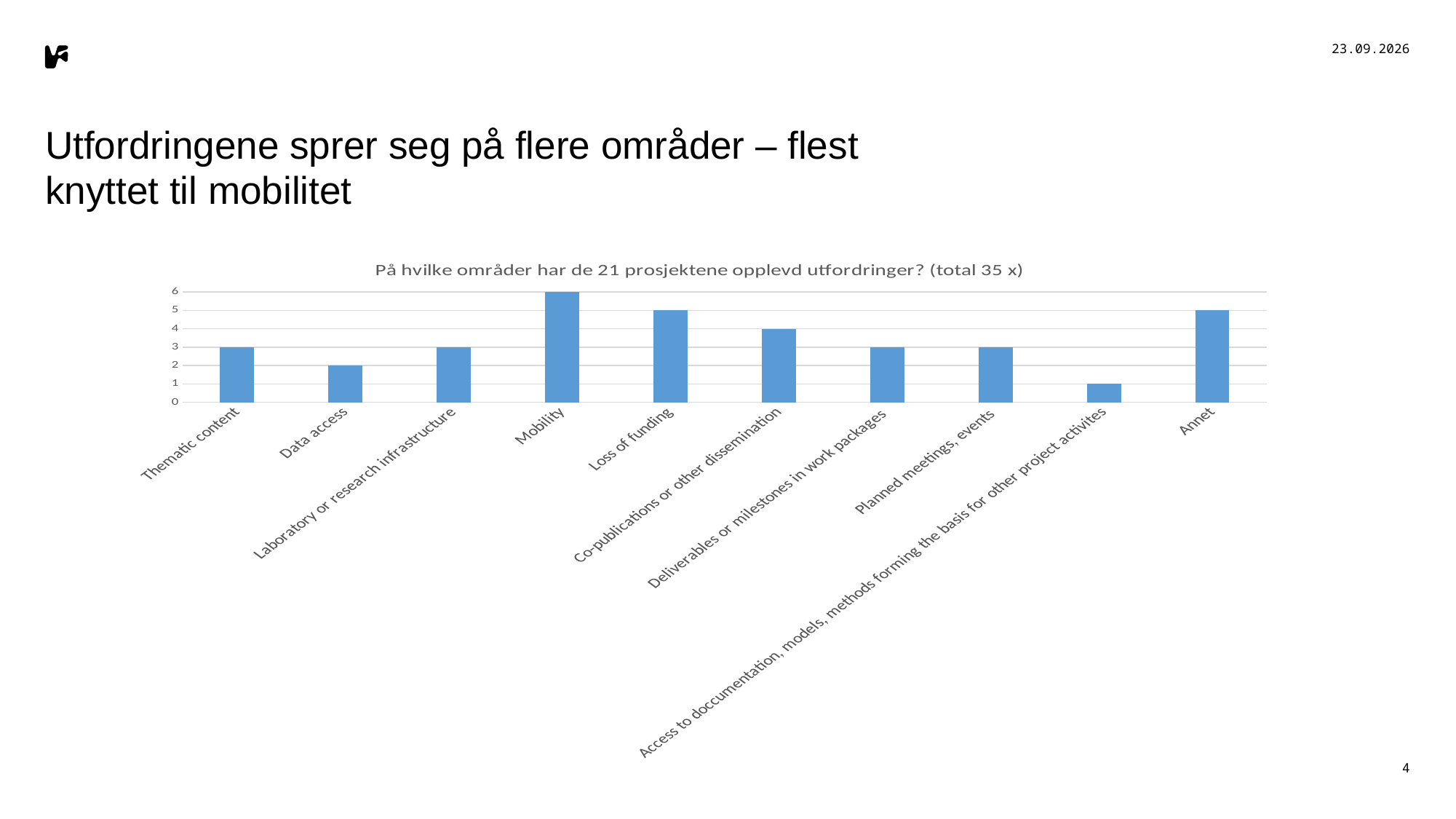
What is the value for Mobility? 6 Is the value for Loss of funding greater or less than 4? greater What is the value for Data access? 2 Which is larger, the value for Thematic content or the value for Data access? Thematic content What is the value for Co-publications or other dissemination? 4 What is the difference between the values for Mobility and Loss of funding? 1 Which category has the highest value in the chart? Mobility What kind of chart is shown on the slide? bar chart What is the value for Annet? 5 What is the title of the chart? På hvilke områder har de 21 prosjektene opplevd utfordringer? (total 35 x) How many categories are shown on the x axis of the chart? 10 Which category has the lowest value in the chart? Access to doccumentation, models, methods forming the basis for other project activites